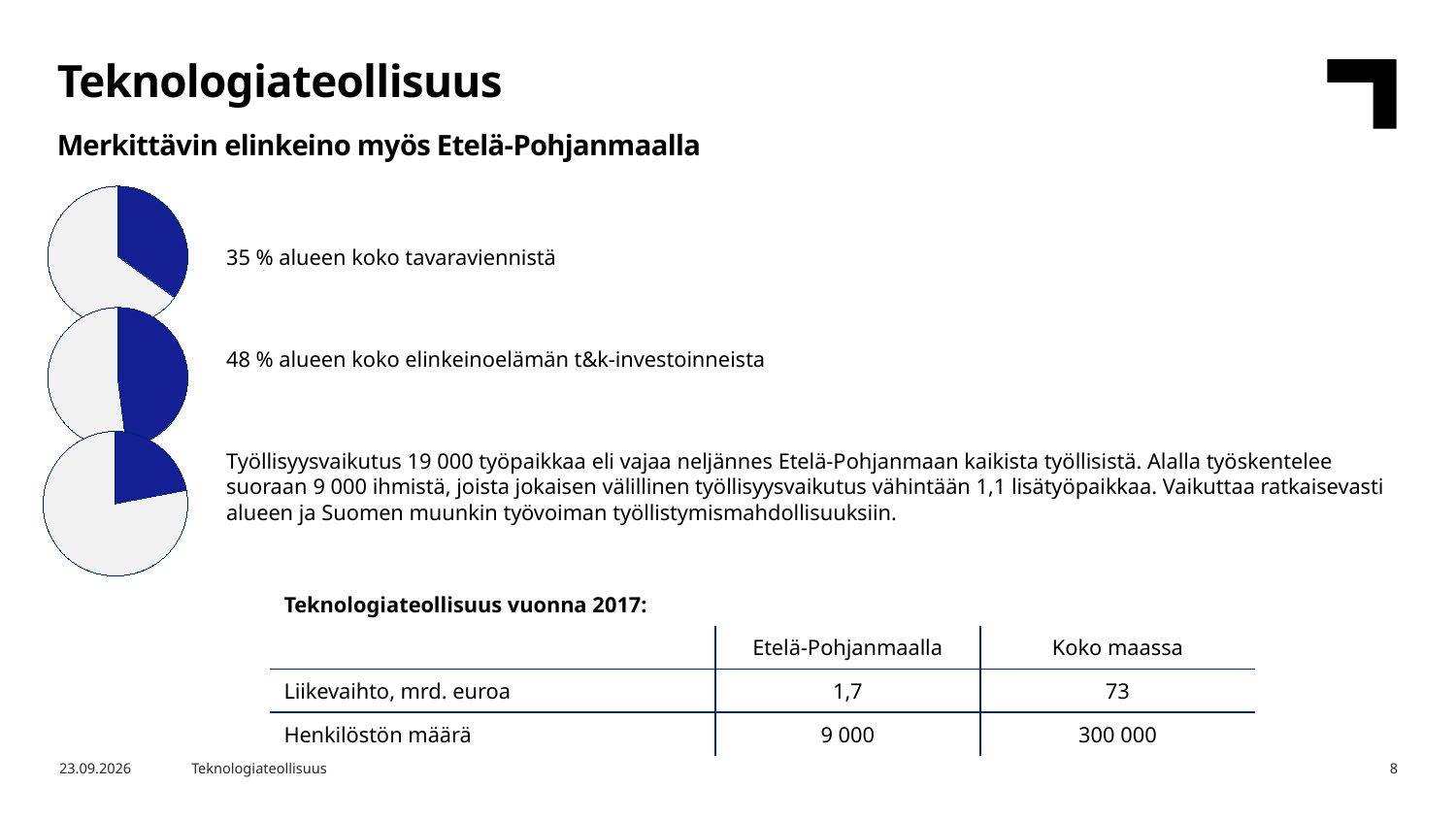
What colour is used for the highlighted slice in each pie chart? Blue Which pie chart has the larger blue slice, the top one (tavaravienti) or the middle one (t&k-investoinnit)? The middle one (t&k-investoinnit) What kind of charts are shown on the left side of the slide? Pie charts Which of the three pie charts has the largest blue slice? The middle one (t&k-investoinnit) In the top pie chart, what share of the region's total goods exports (tavaravienti) does the blue slice represent? 35 % Is the blue slice in the middle pie chart greater or less than 40 %? greater What is the difference in percentage points between the blue slices of the middle pie chart (48 %) and the top pie chart (35 %)? 13 percentage points Which of the three pie charts has the smallest blue slice? The bottom one (työllisyysvaikutus) Is the blue slice in the bottom pie chart greater or less than half of the pie? less How many slices does each pie chart have? 2 How many pie charts are on the slide? 3 In the middle pie chart, what share of the region's business R&D investments (t&k-investoinnit) does the blue slice represent? 48 %